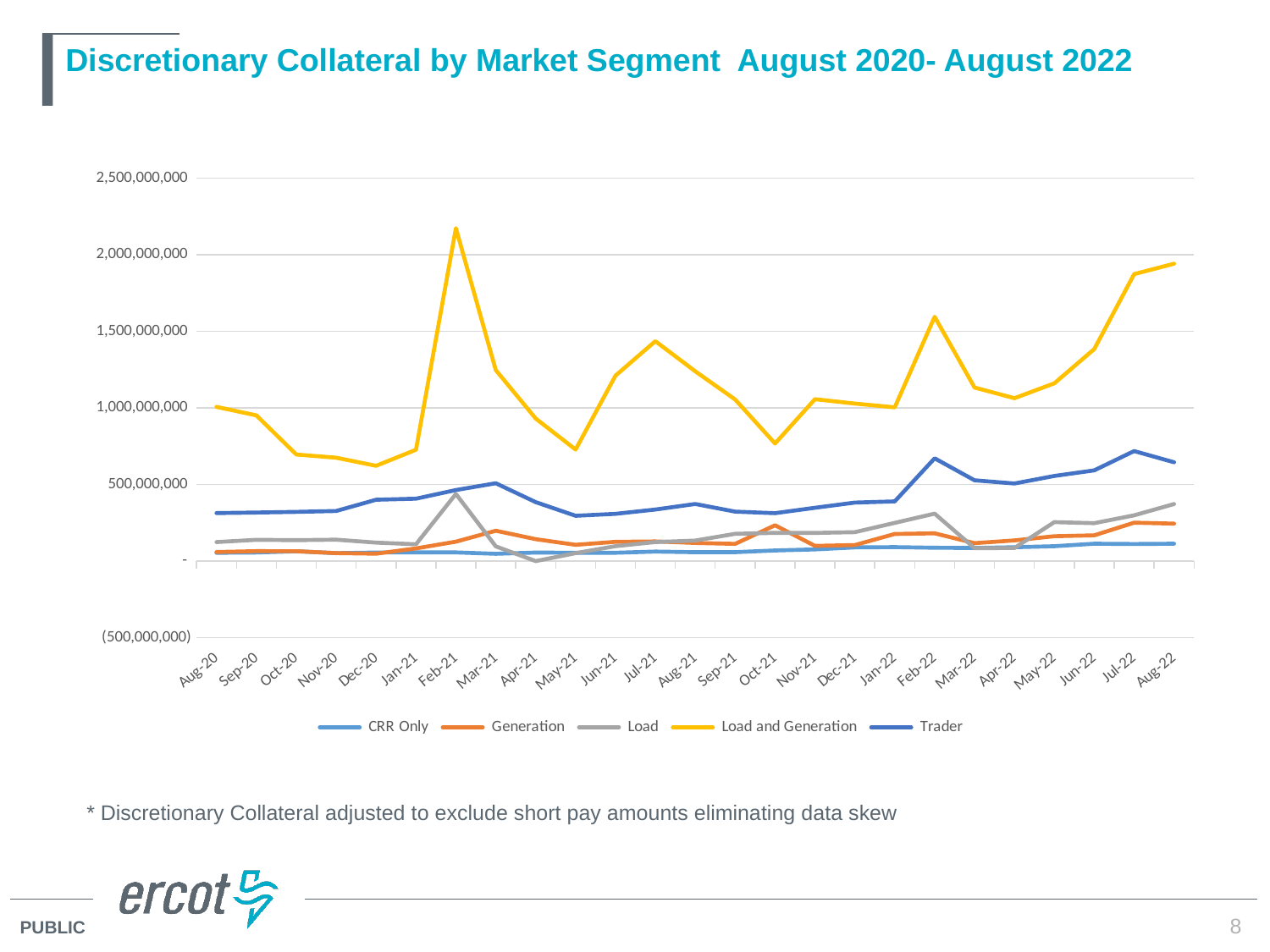
What kind of chart is shown on the slide? Line chart Which series has the lowest value in Aug-22? CRR Only Is the value for Load and Generation in Dec-20 greater or less than 1,000,000,000? less Is the value for Trader in Feb-22 greater or less than 500,000,000? greater Is the value for Load and Generation in Feb-21 greater or less than 2,000,000,000? greater How many months are plotted along the x axis? 25 How many series does the legend list? 5 Does the Load and Generation series rise or fall from May-22 to Aug-22? Rise Which is larger in Aug-22, the Trader value or the Generation value? Trader In which month does the Load and Generation series reach its peak? Feb-21 What is the title of the chart? Discretionary Collateral by Market Segment August 2020- August 2022 Which series has the highest values across the chart? Load and Generation